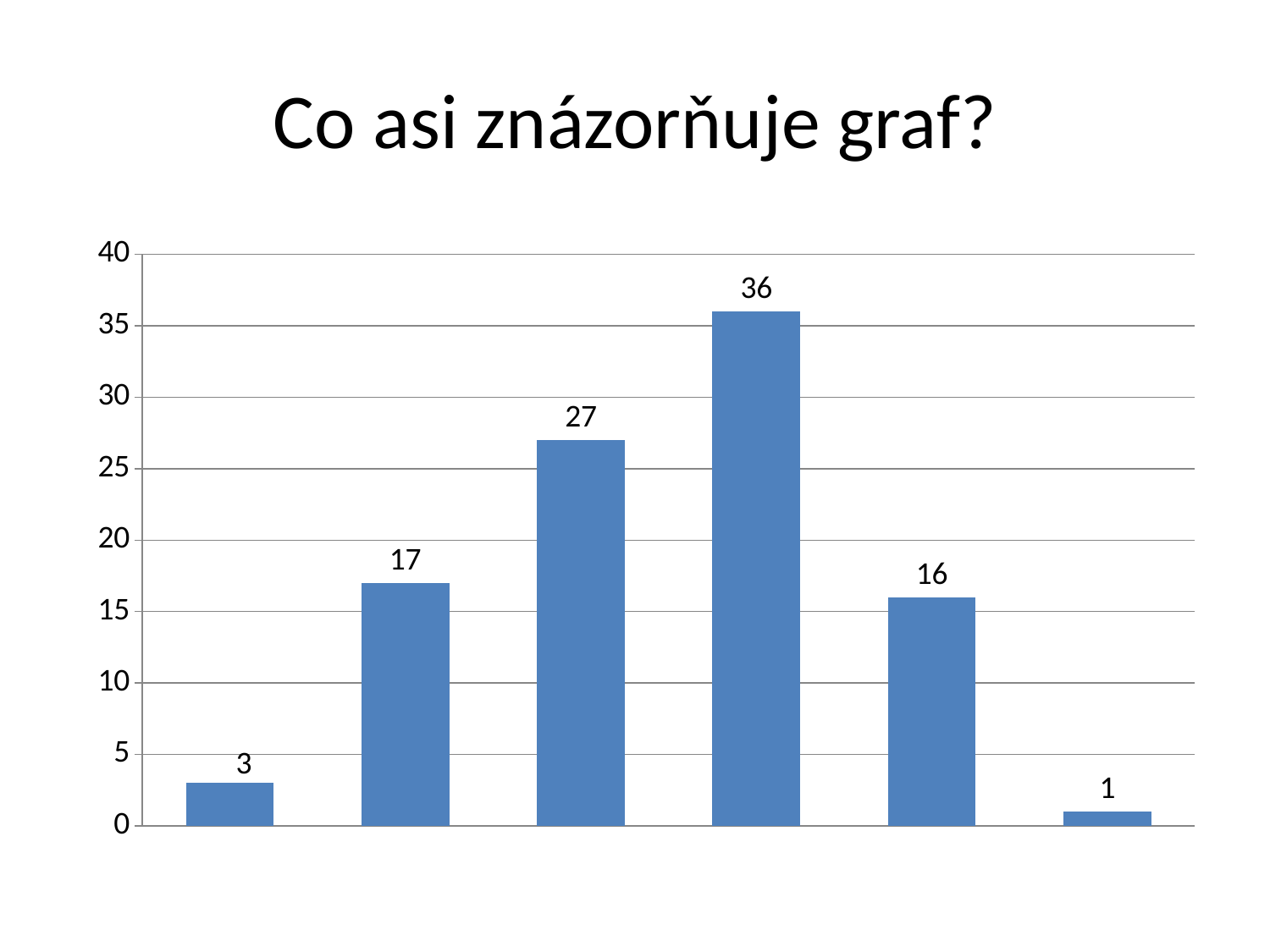
Which is larger, the second bar from the left or the fifth bar from the left? the second bar (17) What type of chart is shown on the slide? bar chart What is the value of the third bar from the left? 27 What is the value of the first bar from the left? 3 What is the title text at the top of the slide? Co asi znázorňuje graf? What is the maximum value shown on the vertical axis? 40 What is the difference between the fourth bar (36) and the third bar (27)? 9 What is the value of the fourth bar from the left? 36 What is the value of the last bar on the right? 1 How many bars does the chart contain? 6 What is the highest value shown in the chart? 36 What is the lowest value shown in the chart? 1